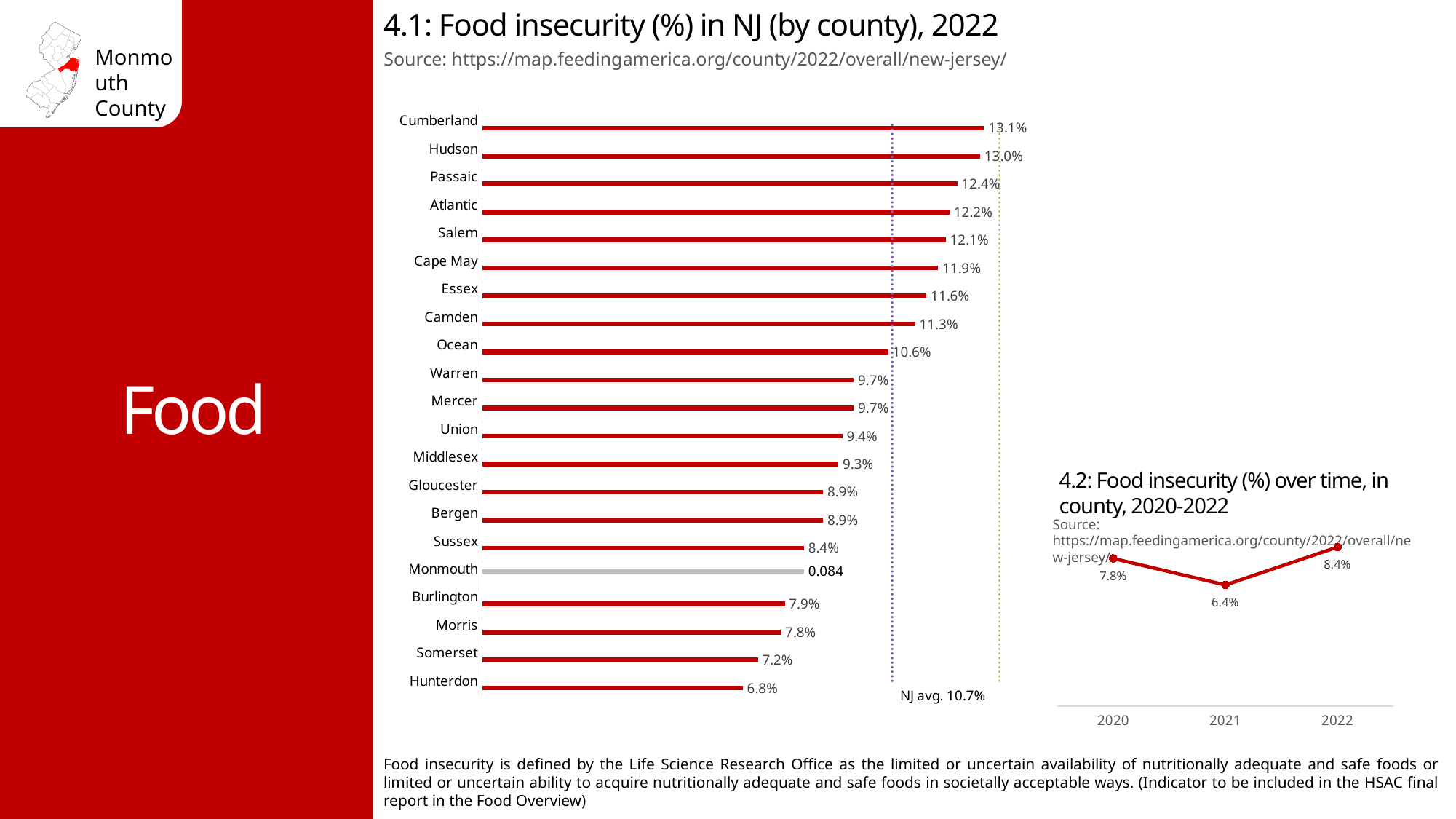
In chart 4.1 (Food insecurity in NJ by county, 2022), which county has the highest value? Cumberland In chart 4.1 (Food insecurity in NJ by county, 2022), what is the value for Ocean? 10.6% In chart 4.1 (Food insecurity in NJ by county, 2022), what NJ average is labelled on the chart? NJ avg. 10.7% In chart 4.1 (Food insecurity in NJ by county, 2022), which is larger, Essex or Camden? Essex What type of chart is chart 4.1 (Food insecurity in NJ by county, 2022)? Bar chart In chart 4.1 (Food insecurity in NJ by county, 2022), what data label is shown for Monmouth? 0.084 In chart 4.2 (Food insecurity over time, 2020-2022), what is the value for 2021? 6.4% In chart 4.1 (Food insecurity in NJ by county, 2022), how many counties are plotted? 21 In chart 4.2 (Food insecurity over time, 2020-2022), what is the difference between 2022 and 2020? 0.6% In chart 4.1 (Food insecurity in NJ by county, 2022), what is the difference between Passaic and Somerset? 5.2% In chart 4.1 (Food insecurity in NJ by county, 2022), what is the value for Cumberland? 13.1% In chart 4.1 (Food insecurity in NJ by county, 2022), which county has the lowest value? Hunterdon